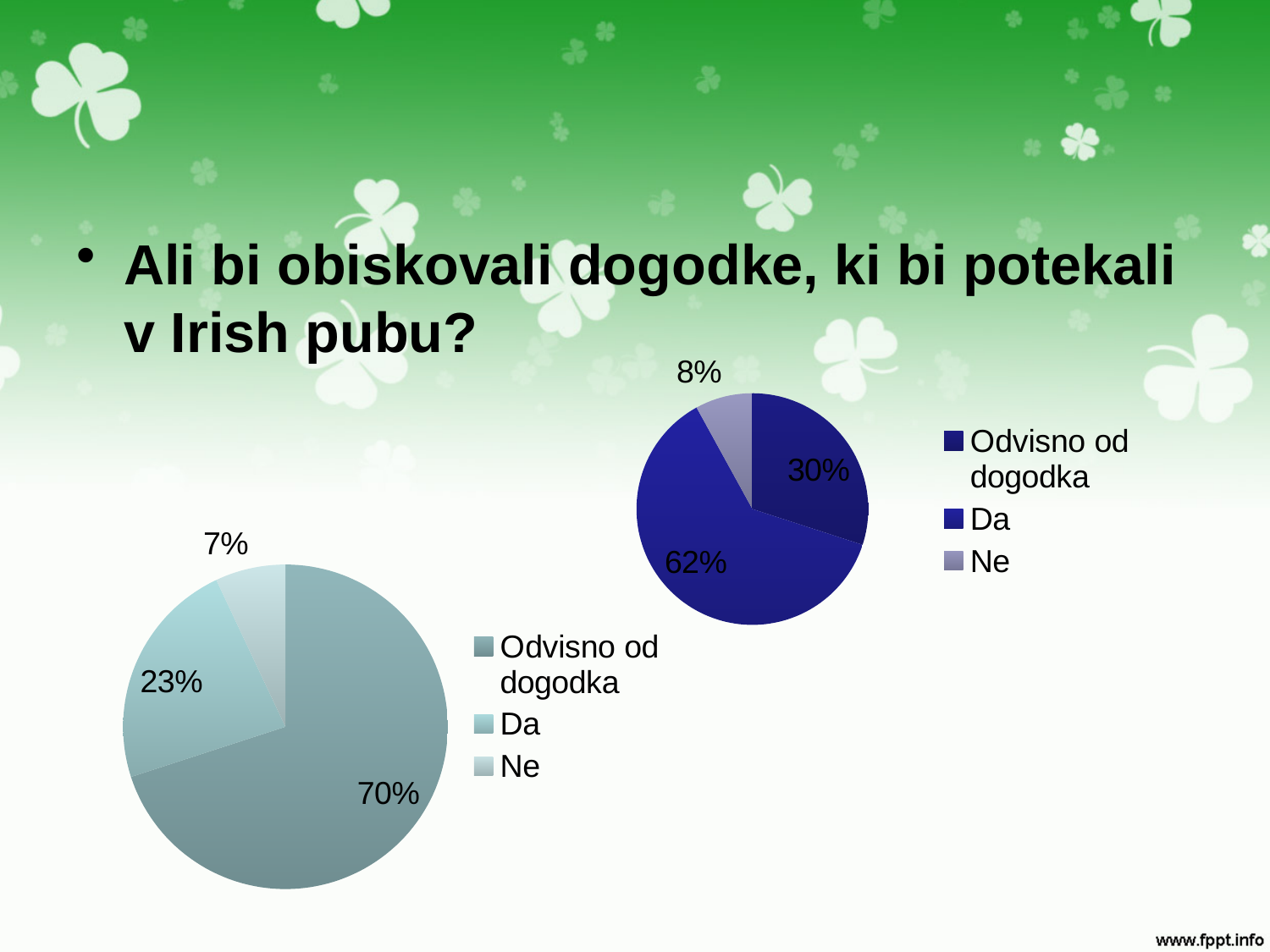
In the top-right pie chart, what is the difference between the "Da" and "Odvisno od dogodka" percentages? 32% In the top-right pie chart, which category has the smallest slice? Ne In the top-right pie chart, what percentage is shown for "Da"? 62% In the top-right pie chart, what percentage is shown for "Odvisno od dogodka"? 30% What type of chart is the bottom-left chart? Pie chart In the bottom-left pie chart, what percentage is shown for "Odvisno od dogodka"? 70% In the top-right pie chart, what percentage is shown for "Ne"? 8% In the bottom-left pie chart, which is larger, "Da" or "Ne"? Da In the bottom-left pie chart, which category has the largest slice? Odvisno od dogodka In the bottom-left pie chart, what percentage is shown for "Ne"? 7% In the bottom-left pie chart, what percentage is shown for "Da"? 23% How many categories does the legend of the top-right pie chart list? 3